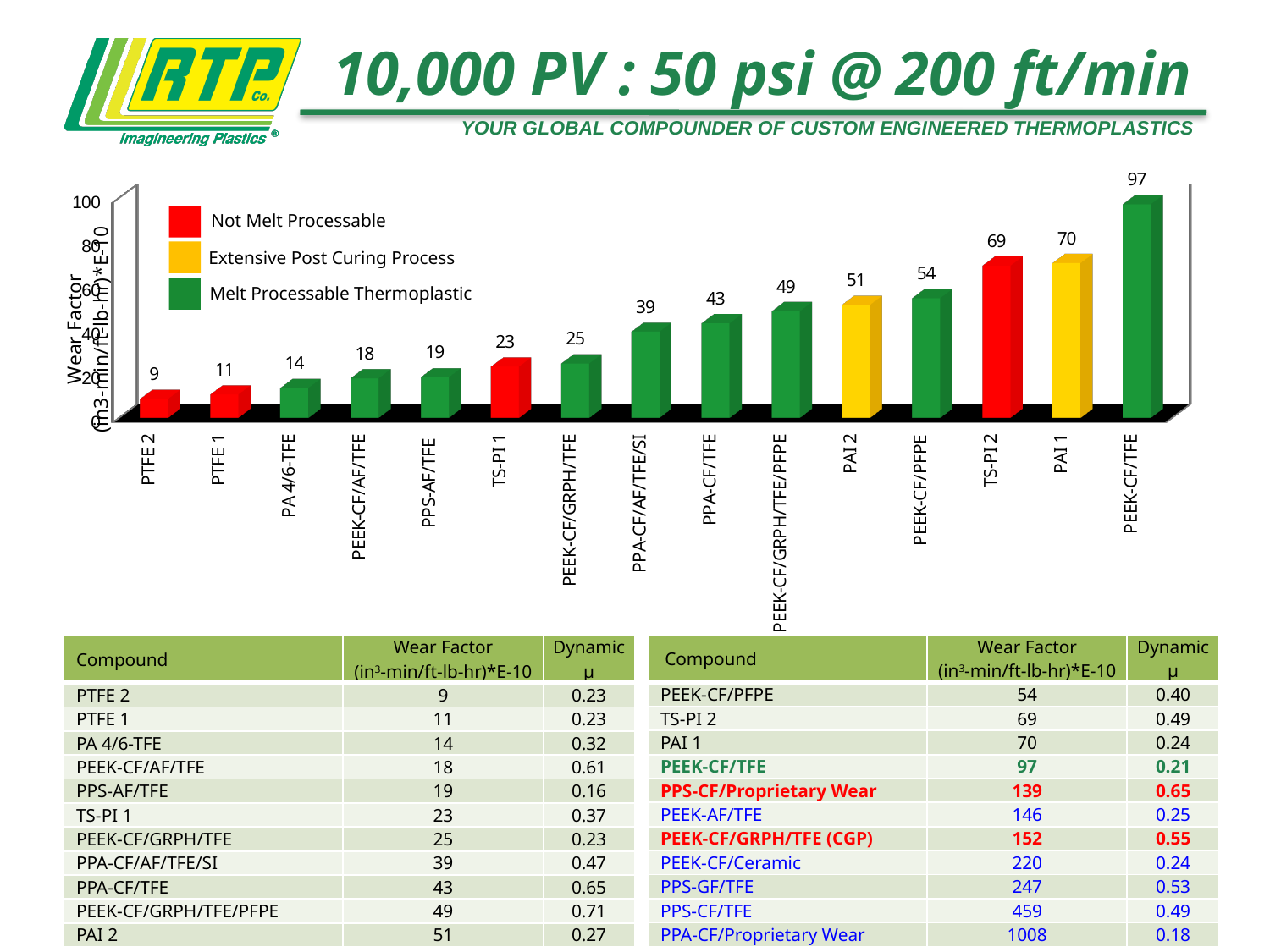
Which compound has the lowest wear factor in the bar chart? PTFE 2 Which compound has the highest wear factor in the bar chart? PEEK-CF/TFE What is the wear factor value shown for PEEK-CF/TFE in the bar chart? 97 Which has a larger wear factor in the bar chart, PPA-CF/TFE or TS-PI 1? PPA-CF/TFE What is the wear factor value shown for PPS-AF/TFE in the bar chart? 19 What is the difference between the wear factor of PAI 1 and TS-PI 2 in the bar chart? 1 What type of chart is used to show the wear factor values? Bar chart How many entries does the chart legend list? 3 What is the wear factor value shown for PAI 2 in the bar chart? 51 Is the wear factor for PEEK-CF/GRPH/TFE/PFPE greater or less than 40 in the bar chart? greater How many compounds are plotted as bars in the chart? 15 What is the difference between the wear factor of PEEK-CF/TFE and PEEK-CF/PFPE in the bar chart? 43